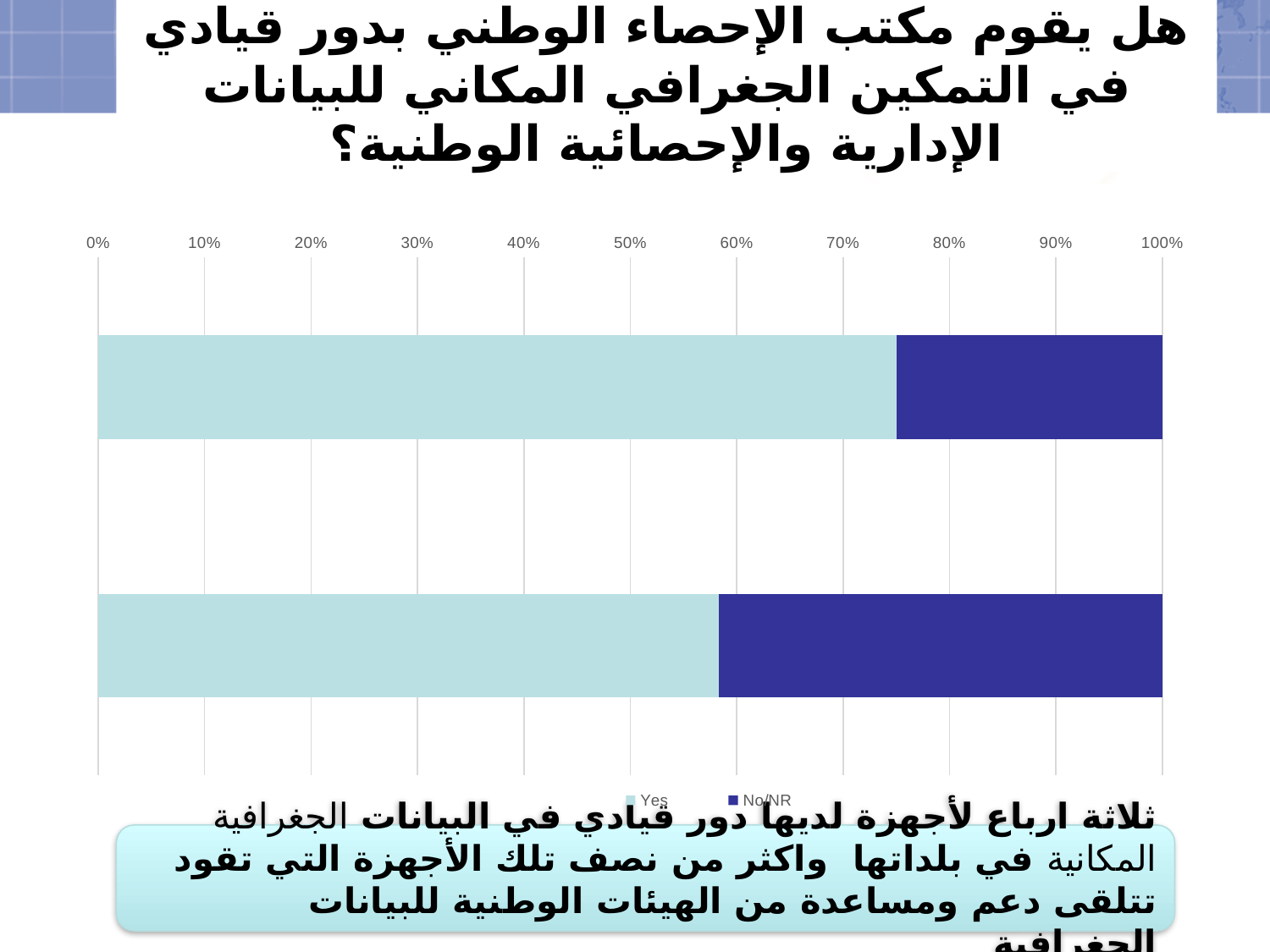
What kind of chart is shown on the slide? Stacked bar chart Which bar has the larger Yes share, the top bar or the bottom bar? The top bar What are the two series named in the legend? Yes and No/NR In the bottom bar, is the No/NR share greater or less than 50%? less In the top bar, is the Yes value greater or less than 70%? greater How many bars are plotted in the chart? 2 In the top bar, which series has the larger share, Yes or No/NR? Yes In the top bar, is the Yes value greater or less than 80%? less Which colour represents the Yes series? Light blue How many series does the legend list? 2